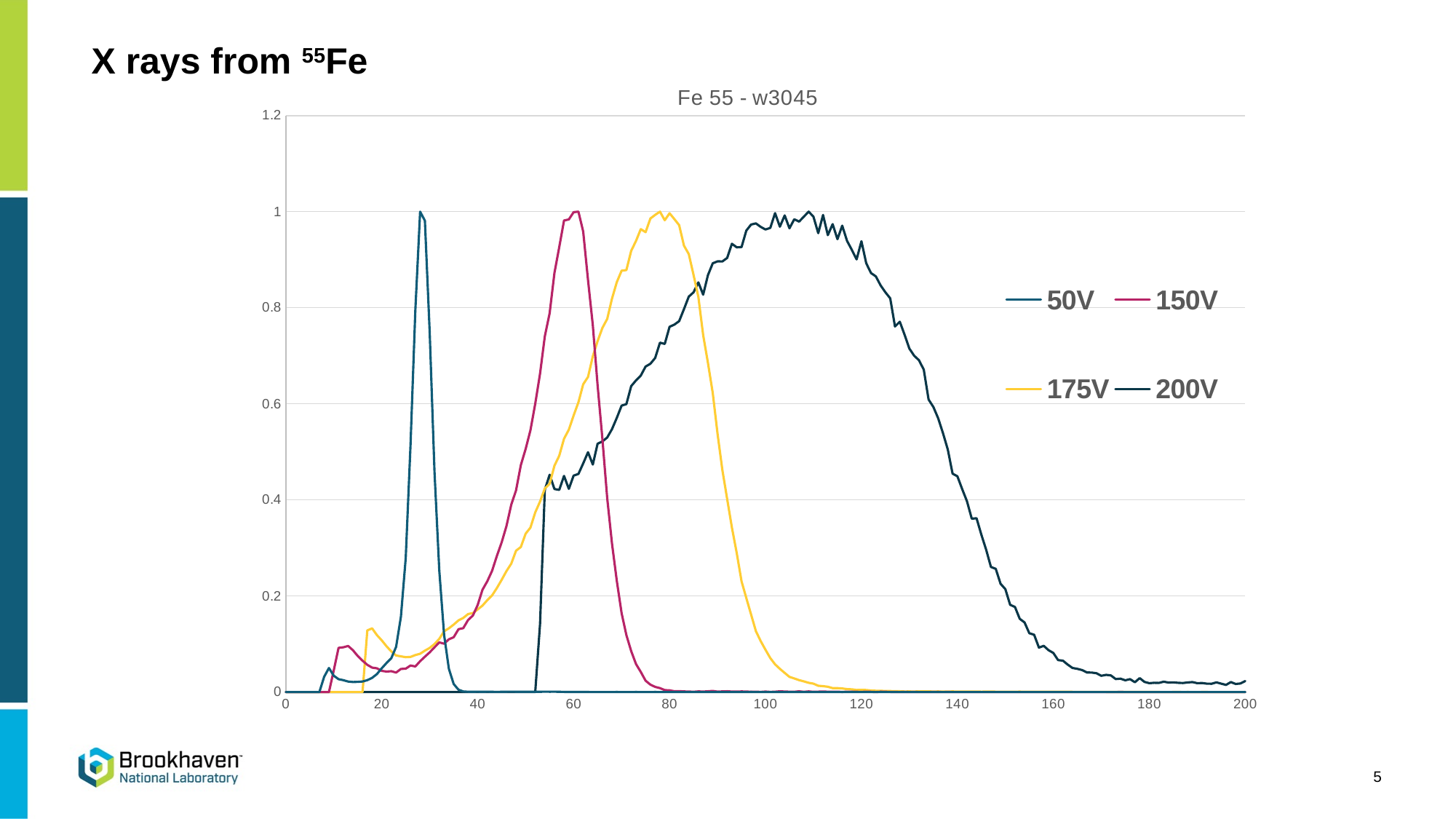
Does the 200V series rise or fall between x = 120 and x = 160? fall What kind of chart is shown on the slide? line chart Is the value of the 175V series at x = 80 greater or less than 0.8? greater What is the title of the chart? Fe 55 - w3045 Is the value of the 150V series at x = 100 greater or less than 0.2? less Which series is drawn in yellow? 175V At x = 60, which series has the higher value, 150V or 200V? 150V Is the value of the 200V series at x = 100 greater or less than 0.8? greater Which series reaches its peak at the largest x value? 200V How many series does the legend list? 4 At x = 120, which series has the higher value, 175V or 200V? 200V